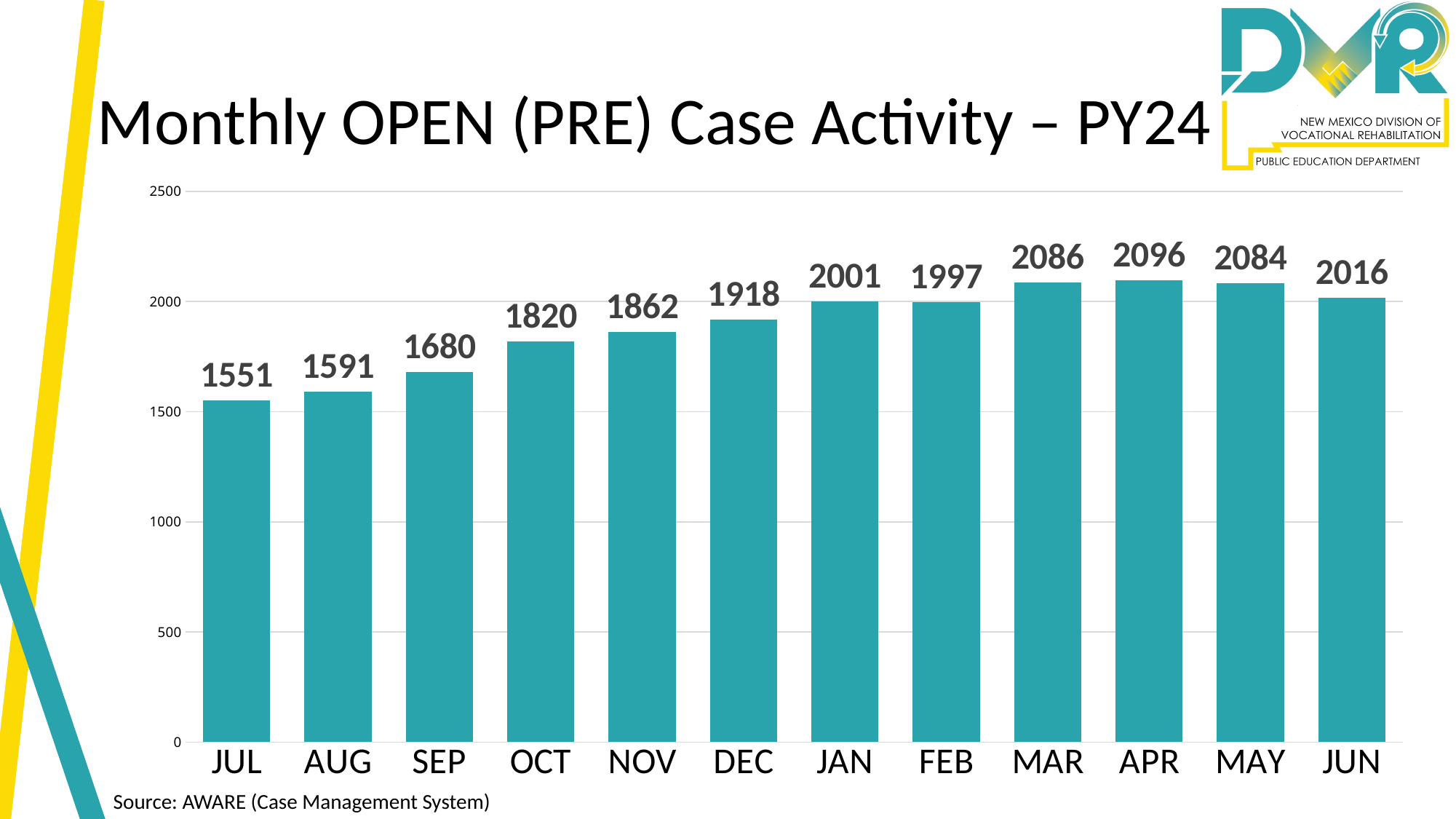
Which is larger, the value for DEC or the value for NOV? DEC How many months are shown on the x axis? 12 Do the values generally rise or fall from JUL to APR? rise What is the title of the chart? Monthly OPEN (PRE) Case Activity – PY24 Is the value for SEP greater or less than 1500? greater What kind of chart is shown on the slide? bar chart Which month has the lowest value? JUL Which month has the highest value? APR What is the value for OCT? 1820 What is the value for FEB? 1997 What is the difference between the values for JUN and JUL? 465 What is the difference between the values for MAR and FEB? 89